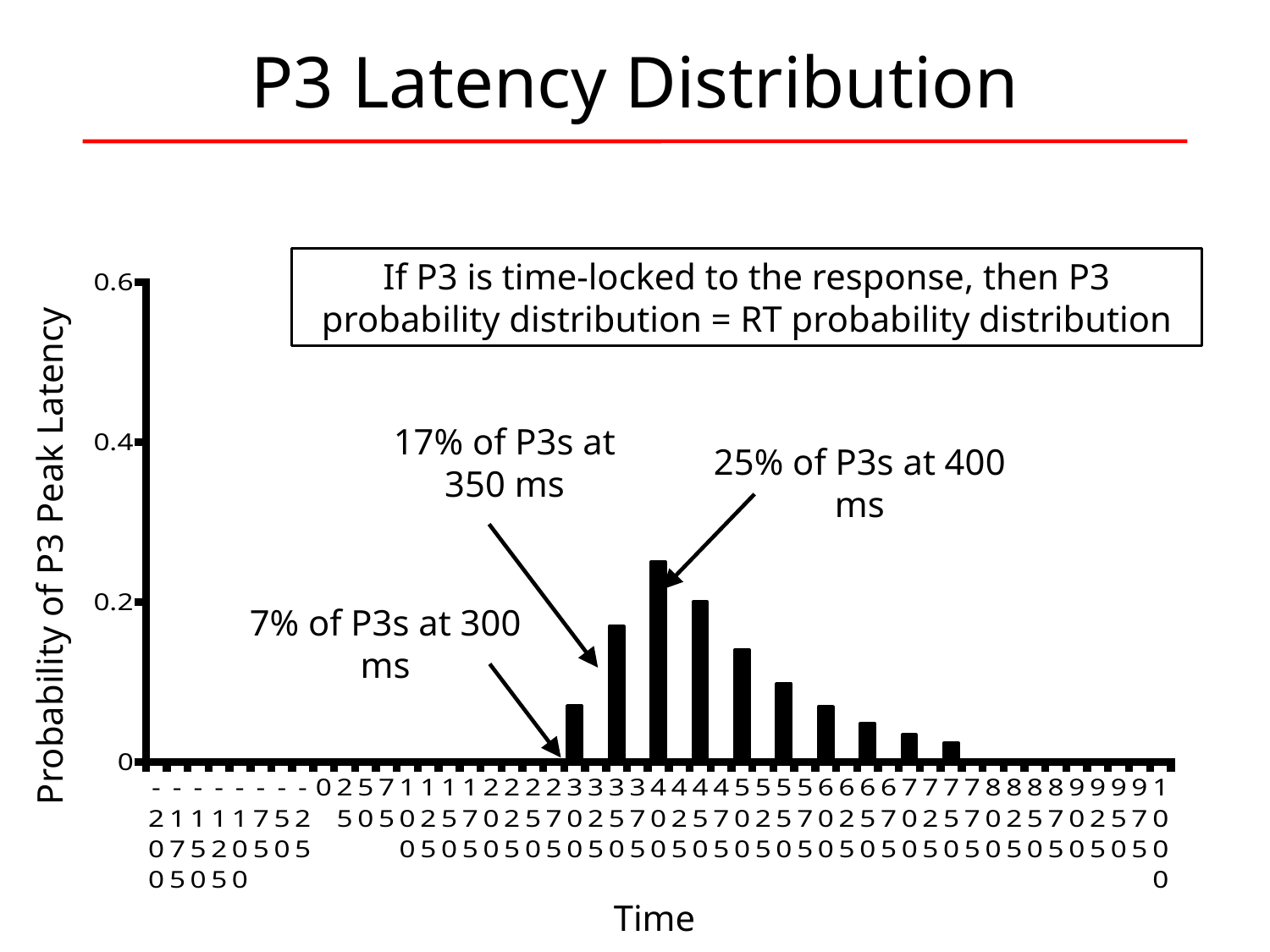
At which time does the probability of P3 peak latency reach its highest value? 400 ms What kind of chart is shown on the slide? bar chart Is the value for 400 ms greater or less than 0.2? greater Which has a higher probability of P3 peak latency, 300 ms or 350 ms? 350 ms Is the value for 450 ms greater or less than 0.4? less What is the difference between the percentage of P3s at 350 ms and at 300 ms? 10% What is the difference between the percentage of P3s at 400 ms and at 350 ms? 8% Do the bar values rise or fall as time increases beyond 400 ms? fall What is the title of the vertical axis? Probability of P3 Peak Latency According to the annotation, what percentage of P3s occur at 350 ms? 17% According to the annotation, what percentage of P3s occur at 300 ms? 7% According to the annotation, what percentage of P3s occur at 400 ms? 25%